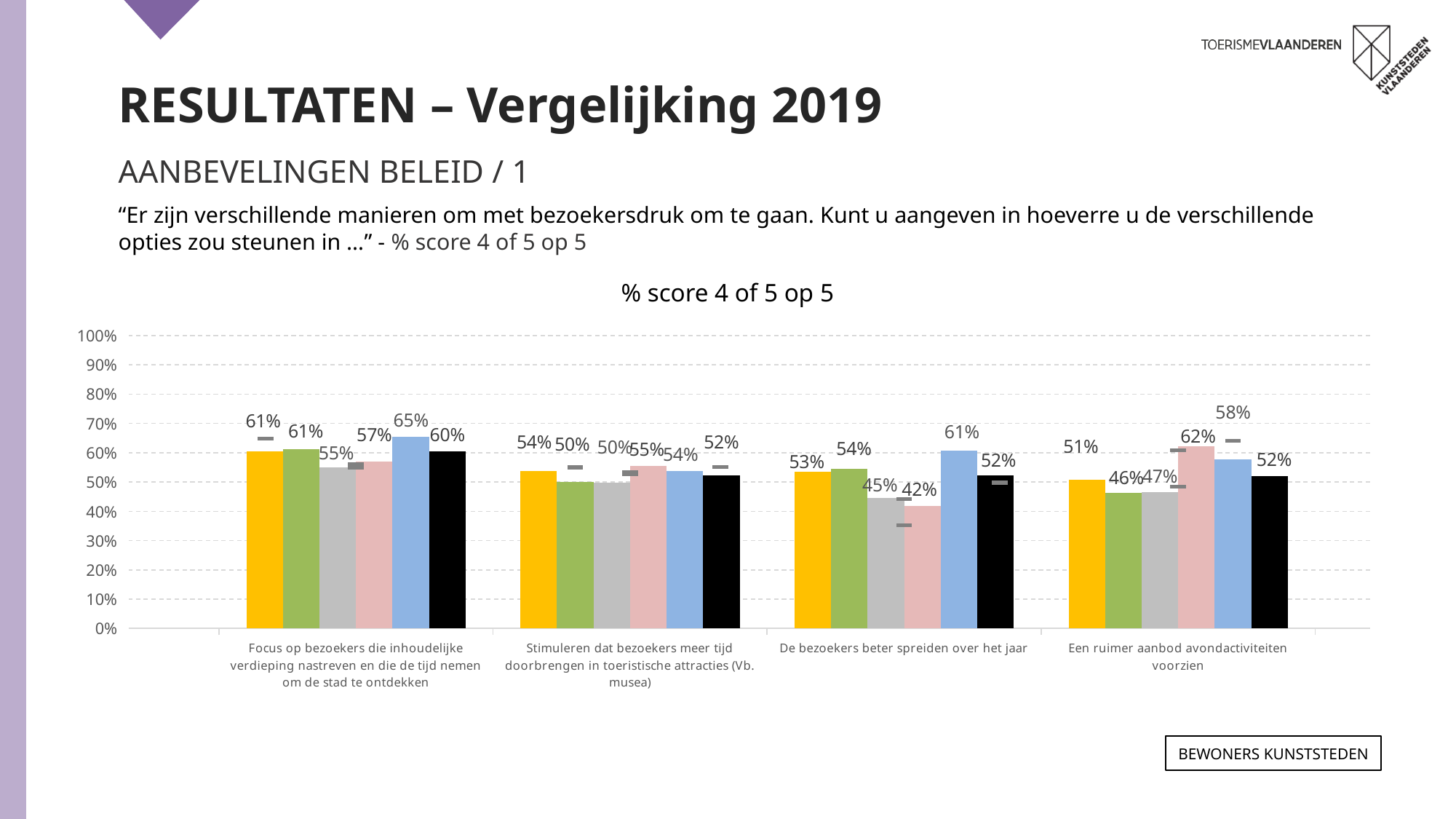
Which bar is the lowest in the category 'De bezoekers beter spreiden over het jaar'? the pink bar (42%) What is the highest value shown on the y axis of the chart? 100% What is the value of the blue bar for 'De bezoekers beter spreiden over het jaar'? 61% Which is larger for 'Een ruimer aanbod avondactiviteiten voorzien': the yellow bar or the pink bar? the pink bar What is the title of the chart? % score 4 of 5 op 5 Which bar is the highest in the category 'Focus op bezoekers die inhoudelijke verdieping nastreven en die de tijd nemen om de stad te ontdekken'? the blue bar (65%) What is the value of the pink bar for 'Een ruimer aanbod avondactiviteiten voorzien'? 62% What is the value of the black bar for 'Stimuleren dat bezoekers meer tijd doorbrengen in toeristische attracties (Vb. musea)'? 52% What is the difference between the blue bar (61%) and the pink bar (42%) for 'De bezoekers beter spreiden over het jaar'? 19 percentage points How many categories are shown along the x axis of the chart? 4 Is the value of the grey bar for 'De bezoekers beter spreiden over het jaar' greater or less than 50%? less What type of chart is shown on the slide? bar chart